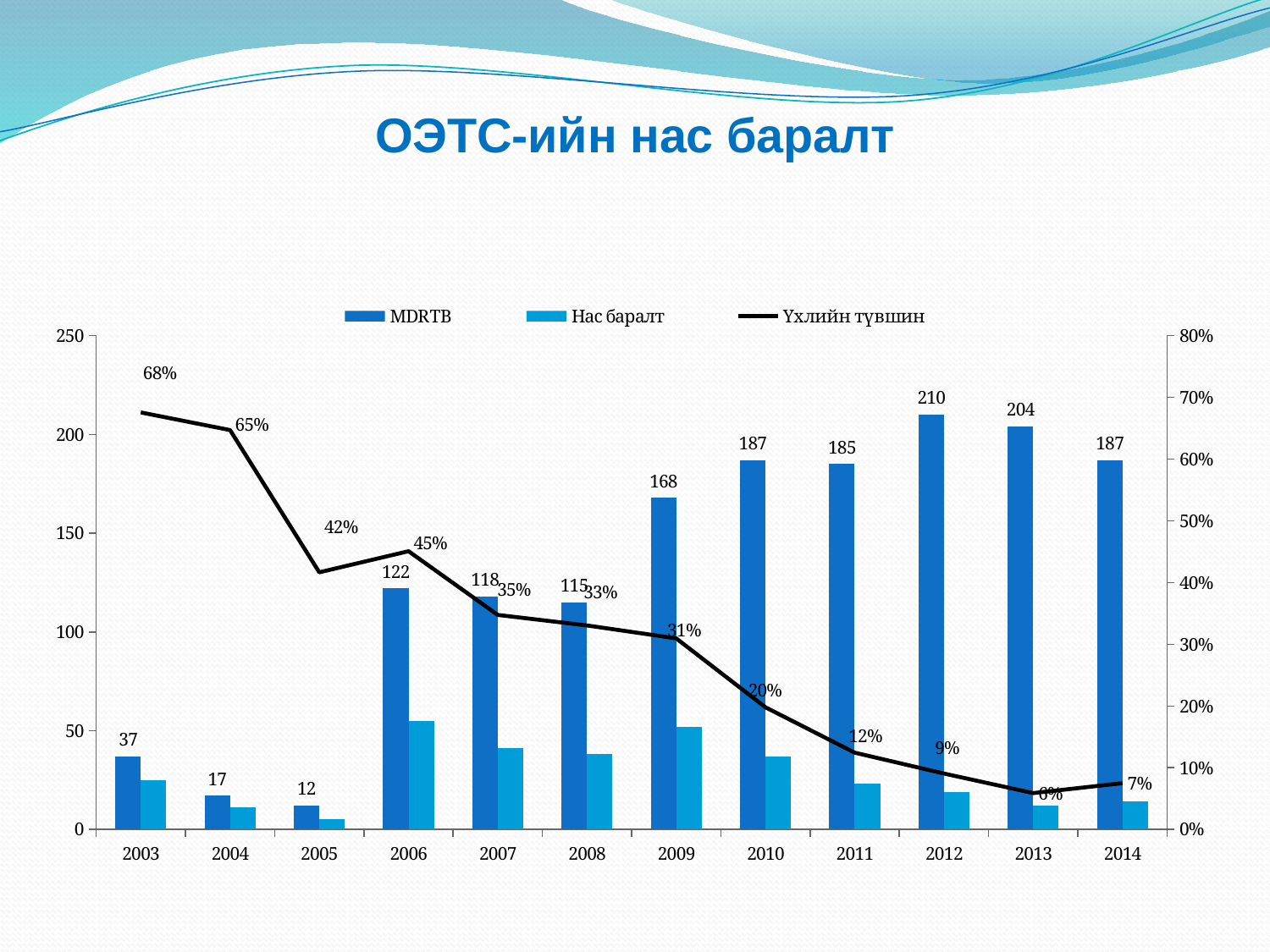
How many years are shown on the x axis? 12 Is the Нас баралт value for 2006 greater or less than 50? greater What is the MDRTB value for 2012? 210 What is the Үхлийн түвшин value for 2003? 68% Does the Үхлийн түвшин line generally rise or fall from 2003 to 2014? fall What is the MDRTB value for 2005? 12 How many series does the legend list? 3 What is the title of the slide? ОЭТС-ийн нас баралт Which is larger, the MDRTB value for 2010 or for 2011? 2010 What is the difference between the MDRTB values for 2012 and 2013? 6 Which year has the highest MDRTB value? 2012 Which year has the lowest Үхлийн түвшин value? 2013